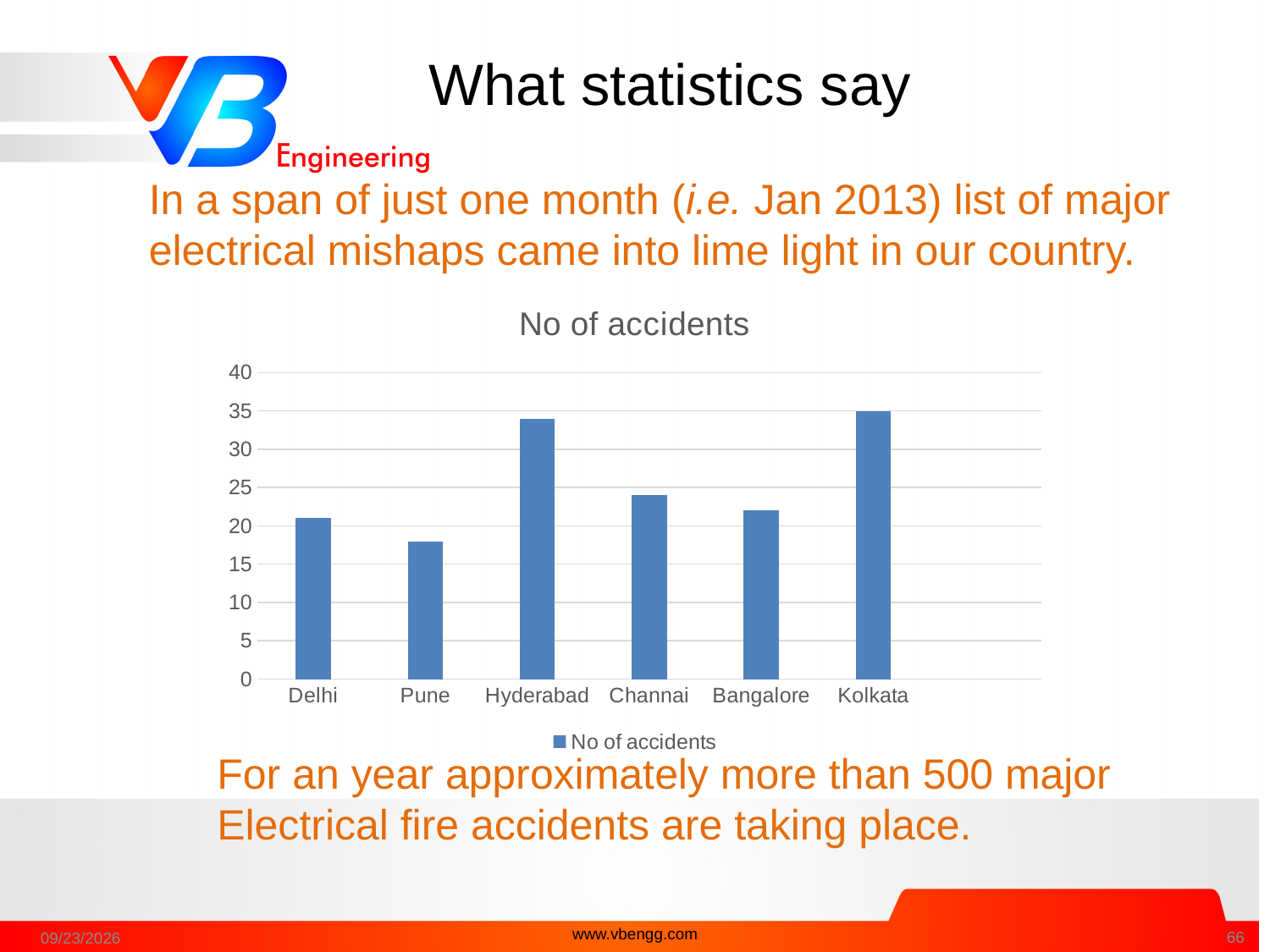
How many series does the chart legend list? 1 Is the value for Hyderabad greater or less than 30? greater What is the title of the chart? No of accidents Is the value for Pune greater or less than 20? less How many cities are shown on the x axis of the chart? 6 Is the value for Channai greater or less than 20? greater Which city has the lowest number of accidents? Pune Which has more accidents, Channai or Delhi? Channai Which has more accidents, Hyderabad or Pune? Hyderabad What kind of chart is shown on the slide? bar chart